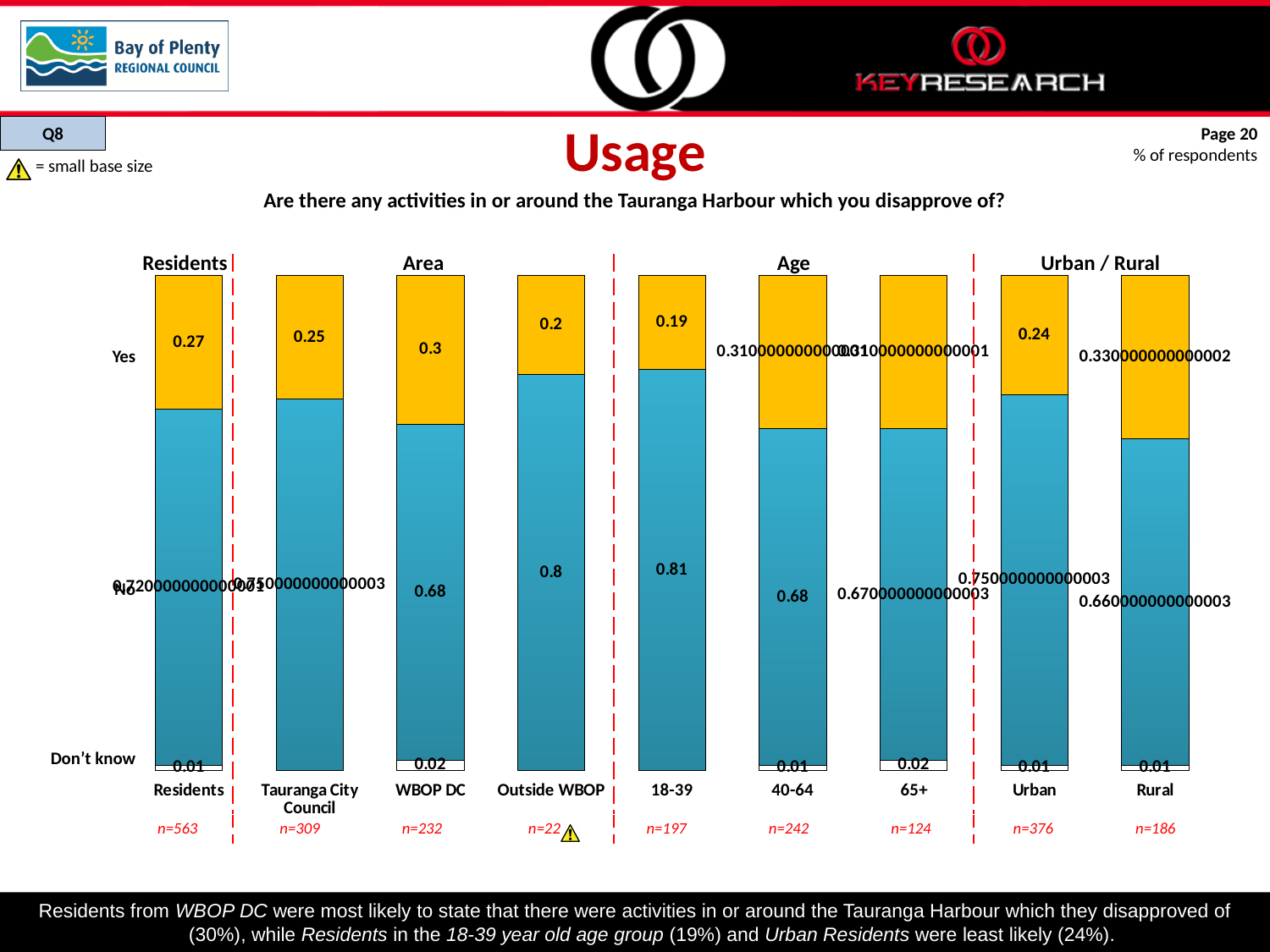
What is the 'Yes' value for Urban residents? 0.24 Which has the larger 'Yes' value, WBOP DC or Outside WBOP? WBOP DC What is the 'Yes' value for WBOP DC? 0.3 What is the 'No' value for Outside WBOP? 0.8 What is the difference between the 'Yes' value for Residents and the 'Yes' value for Tauranga City Council? 0.02 What is the 'Yes' value for the 18-39 age group? 0.19 How many categories (bars) are shown along the x axis? 9 What is the 'Don't know' value for WBOP DC? 0.02 How many series are stacked in each bar? 3 Which category is flagged with the small base size warning symbol? Outside WBOP What is the 'No' value for the 18-39 age group? 0.81 What kind of chart is shown on the slide? Stacked bar chart